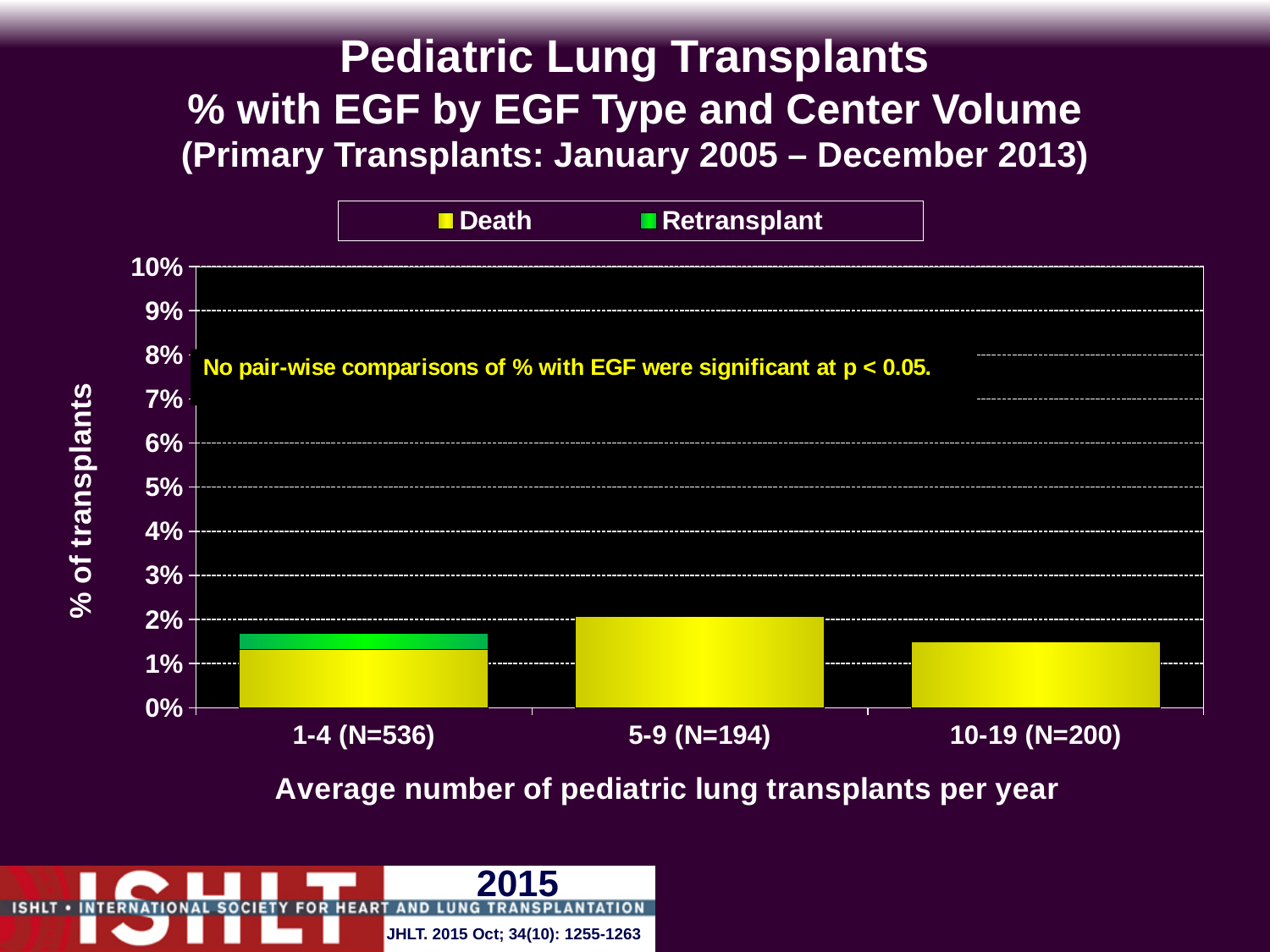
What is the x-axis title of the chart? Average number of pediatric lung transplants per year Is the total bar for 1-4 (N=536) greater or less than 2%? less Which center volume category has the tallest bar overall? 5-9 (N=194) Is the Death value for 10-19 (N=200) greater or less than 2%? less How many center volume categories are shown on the x axis? 3 Which center volume category is the only one showing a Retransplant segment? 1-4 (N=536) Is the Death value for 1-4 (N=536) greater or less than 1%? greater Which is larger, the total bar for 5-9 (N=194) or for 10-19 (N=200)? 5-9 (N=194) What kind of chart is shown on the slide? bar chart How many series does the legend list? 2